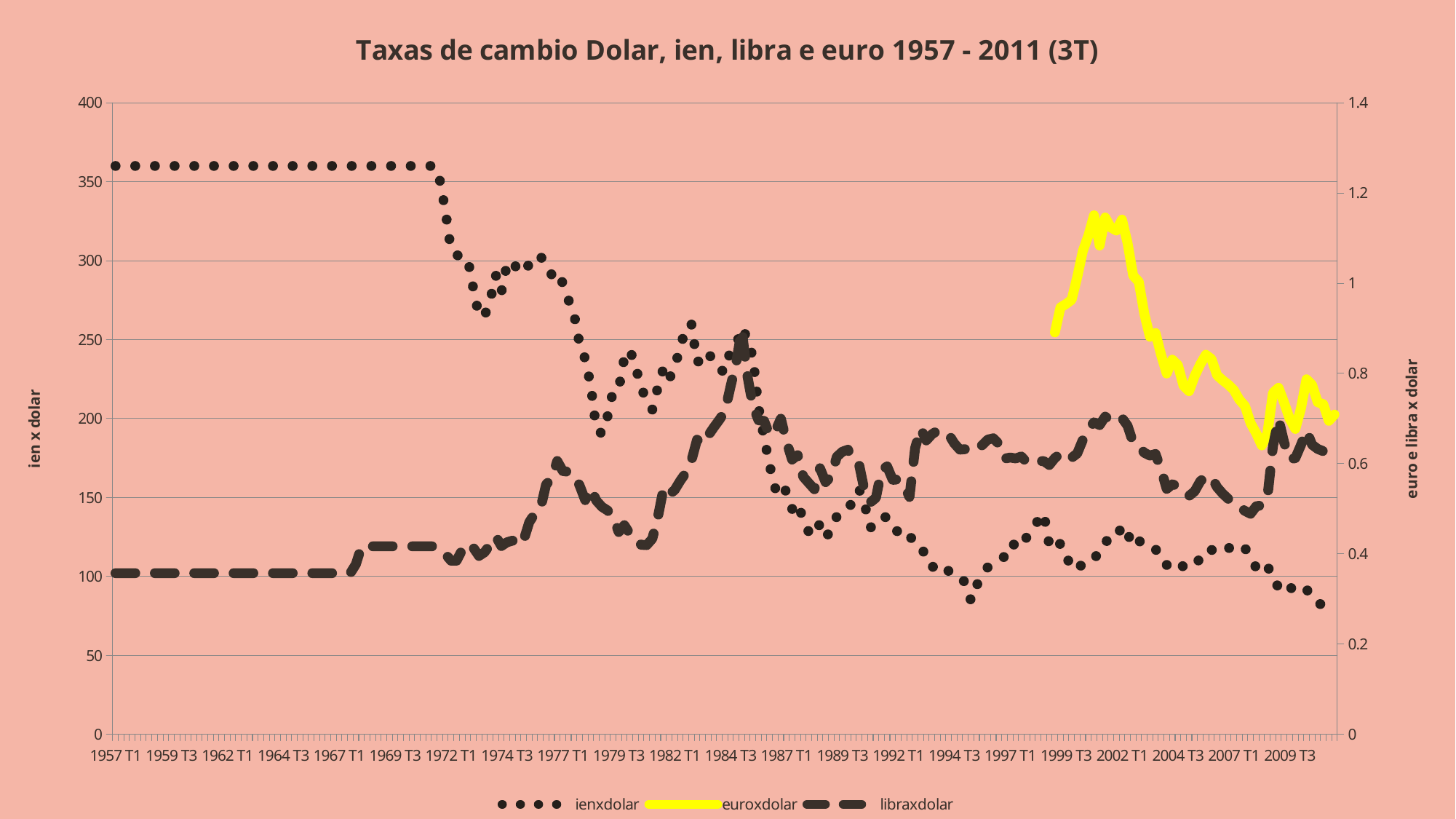
How many series does the legend list? 3 Does the euroxdolar series rise or fall from its 2002 peak to 2011? fall Which is larger, the ienxdolar value in 1957 or in 2011? 1957 Is the value of ienxdolar in 1957 greater or less than 300? greater Which series is drawn in yellow? euroxdolar Is the value of ienxdolar at the end of the series (2011) greater or less than 100? less Does the ienxdolar series overall rise or fall from 1957 to 2011? fall What kind of chart is shown on the slide? line chart Is the value of libraxdolar in 1957 greater or less than 0.4? less What is the title of the chart? Taxas de cambio Dolar, ien, libra e euro 1957 - 2011 (3T) Which series reaches the highest value on the right-hand axis (euro e libra x dolar)? euroxdolar